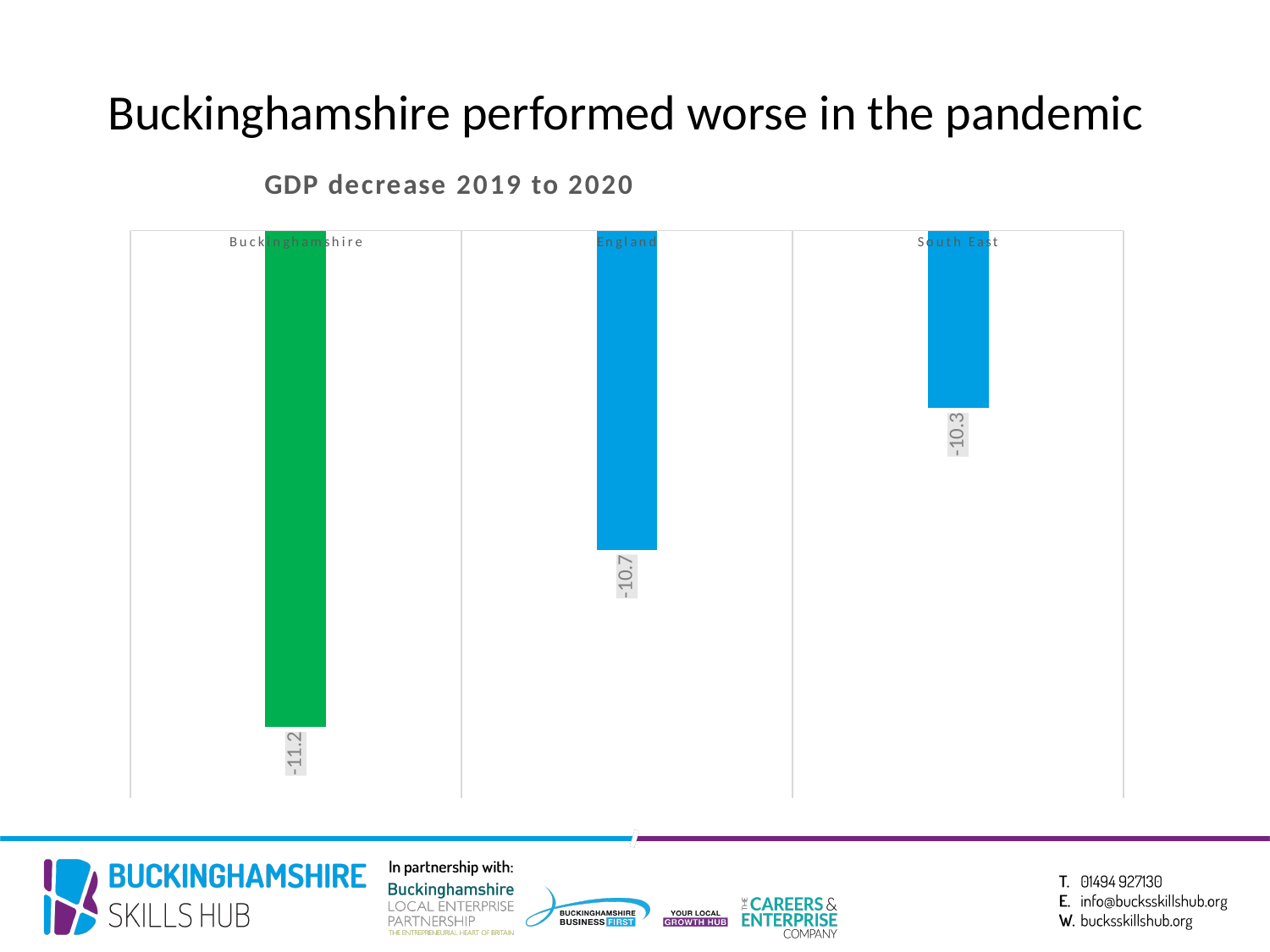
What is the title of the chart? GDP decrease 2019 to 2020 What is the difference between the values for Buckinghamshire and South East? 0.9 What is the value for South East in the chart? -10.3 What is the value for Buckinghamshire in the GDP decrease 2019 to 2020 chart? -11.2 Which category has the highest (least negative) value in the chart? South East What is the difference between the values for England and South East? 0.4 How many categories are shown in the chart? 3 What is the value for England in the chart? -10.7 Which category has the lowest (most negative) value in the chart? Buckinghamshire Which of England or South East has the larger (less negative) value? South East What is the difference between the values for Buckinghamshire and England? 0.5 What kind of chart is shown on the slide? Bar chart